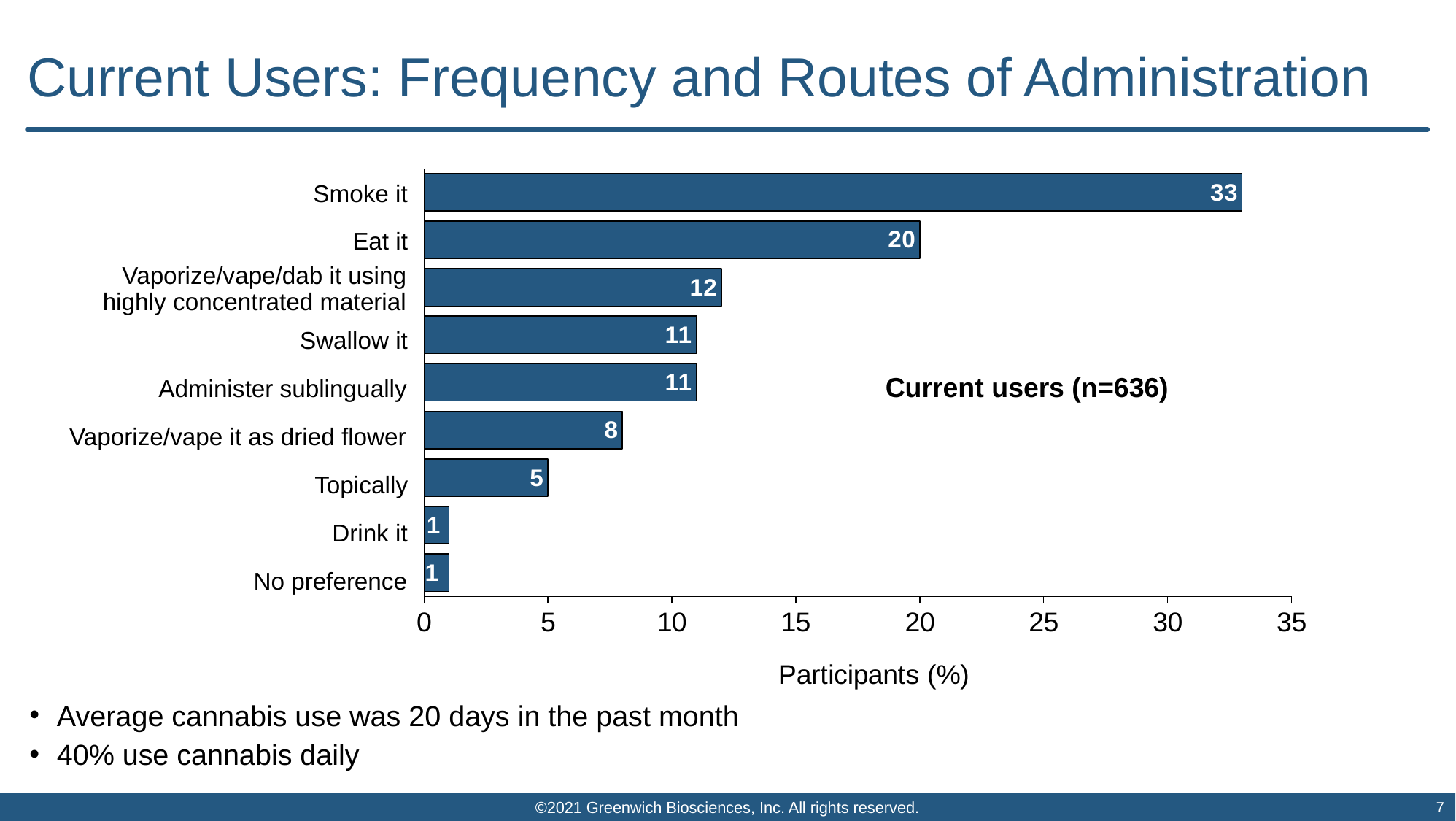
Which route of administration has the highest value? Smoke it Which is larger, the value for Swallow it or the value for Vaporize/vape it as dried flower? Swallow it What is the value for Eat it? 20 What is the value for Topically? 5 What is the total of the values for Drink it and No preference? 2 What is the value for Vaporize/vape/dab it using highly concentrated material? 12 How many categories are shown on the chart? 9 What percentage of participants smoke it? 33 What is the label of the horizontal axis? Participants (%) What is the difference between the values for Smoke it and Eat it? 13 What kind of chart is shown on the slide? Bar chart What is the sample size of current users shown on the chart? n=636